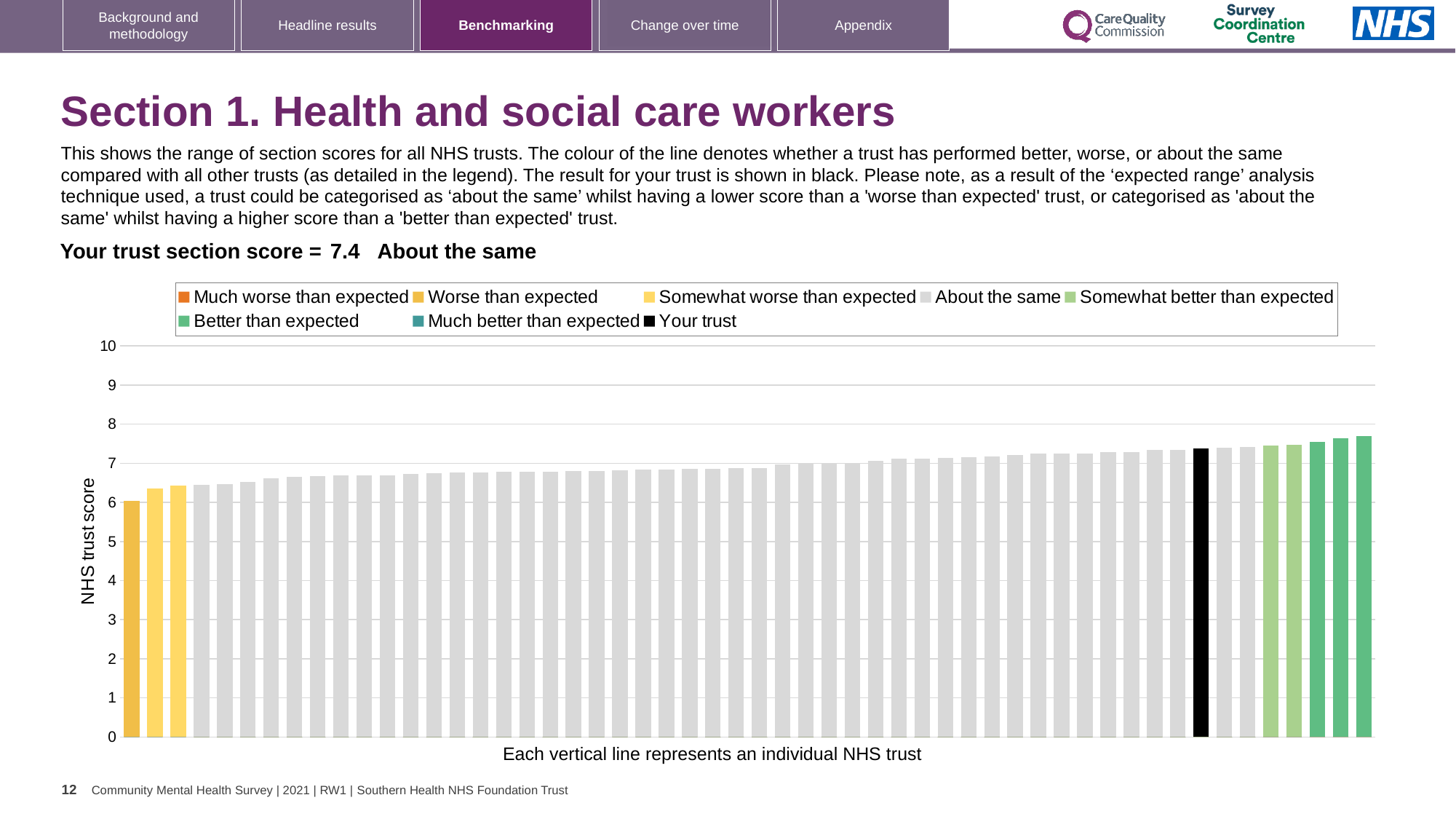
Is the value of the highest bar in the chart greater or less than 7? greater How many bars are coloured as 'Worse than expected' (yellow)? 1 Which is larger: the black bar for your trust or the leftmost bar in the chart? the black bar for your trust Do the bar values rise or fall from left to right along the x axis? rise What kind of chart is shown on the slide? bar chart How many entries does the chart legend list? 8 What is the section score for your trust shown on the slide? 7.4 How many bars are coloured as 'Better than expected' (green)? 3 Is the value of the highest bar in the chart greater or less than 8? less How is your trust's section score categorised on the slide? About the same Is the value of the lowest bar in the chart greater or less than 7? less What is the label on the vertical axis of the chart? NHS trust score